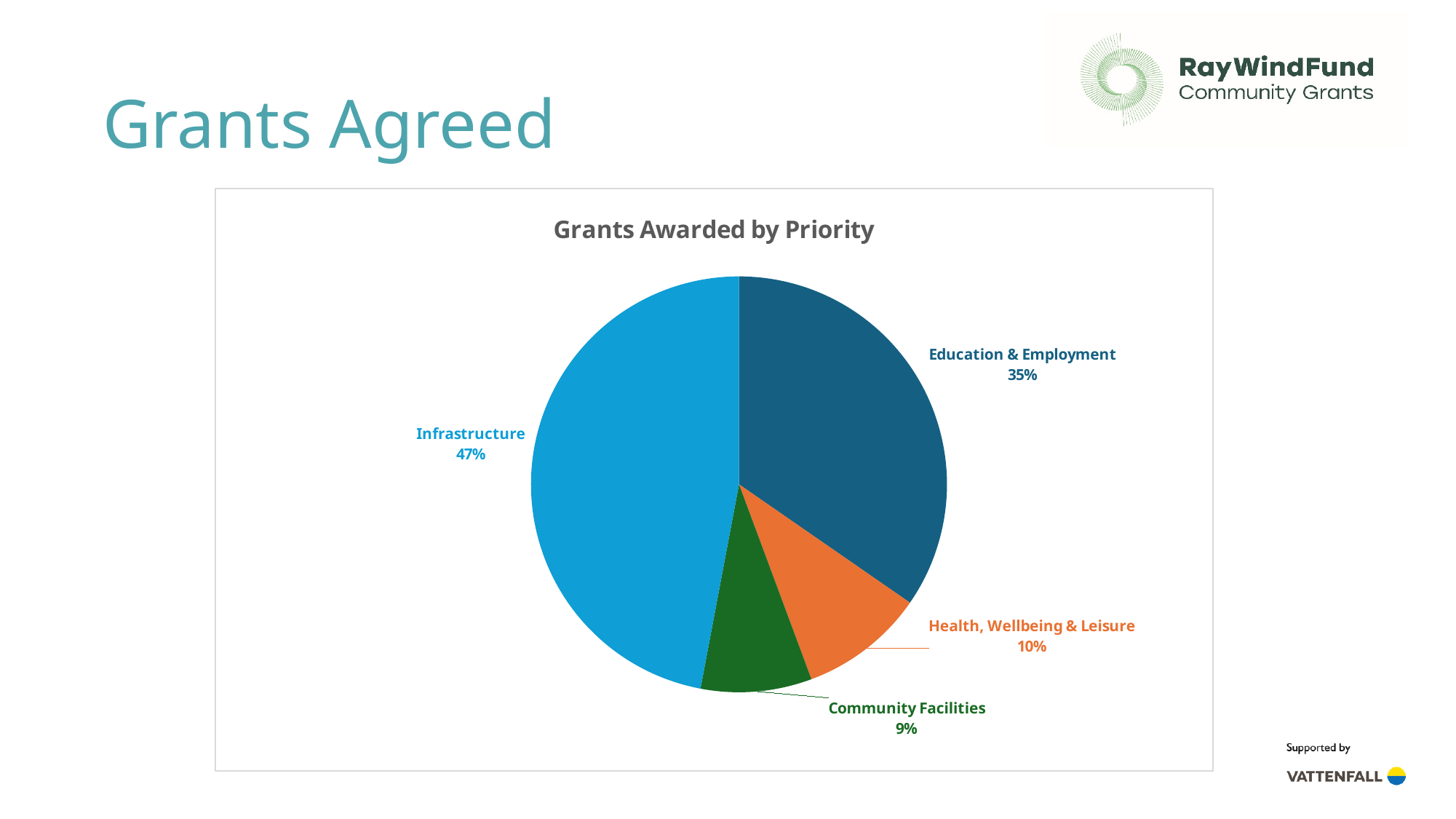
What share of grants was awarded to Community Facilities? 9% Which priority received the smallest share of grants? Community Facilities Which received a larger share of grants, Health, Wellbeing & Leisure or Community Facilities? Health, Wellbeing & Leisure What is the difference in percentage points between Infrastructure and Education & Employment? 12 How many priority categories are shown in the pie chart? 4 What share of grants was awarded to Education & Employment? 35% Which priority received the largest share of grants? Infrastructure What share of grants was awarded to Health, Wellbeing & Leisure? 10% What colour is the Community Facilities slice? Green What share of grants was awarded to Infrastructure? 47% What kind of chart is shown on the slide? Pie chart What is the title of the chart? Grants Awarded by Priority